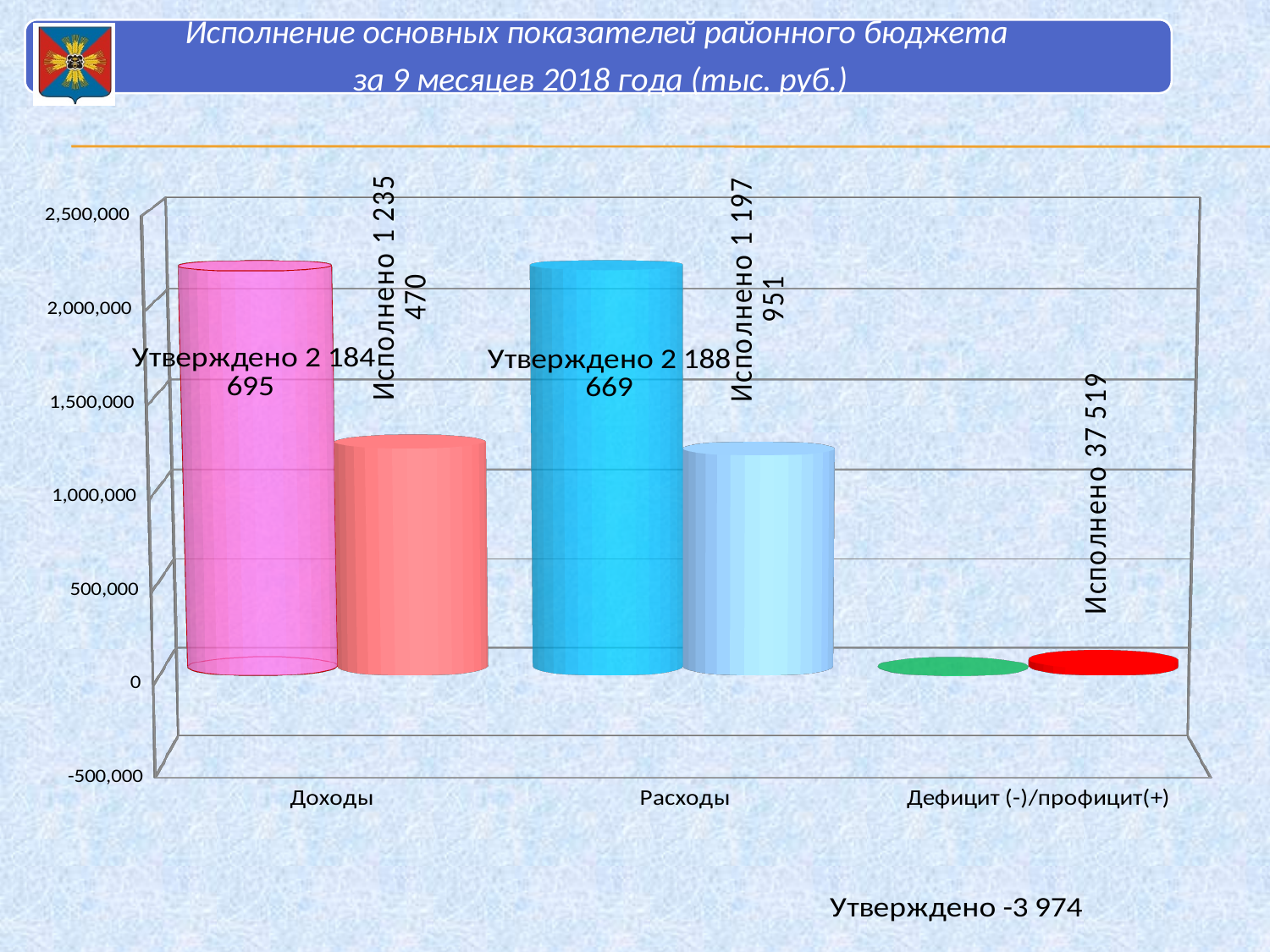
Is the executed value for Доходы greater or less than 1,000,000? greater Which is larger: the executed value for Доходы or the executed value for Расходы? Доходы What is the approved (Утверждено) value for Дефицит (-)/профицит(+)? -3 974 What is the executed (Исполнено) value for Дефицит (-)/профицит(+)? 37 519 What is the executed (Исполнено) value for Доходы? 1 235 470 What is the approved (Утверждено) value for Расходы? 2 188 669 What is the difference between the approved and executed values for Доходы? 949 225 What is the executed (Исполнено) value for Расходы? 1 197 951 How many categories are shown on the x axis of the chart? 3 What type of chart is shown on the slide? Bar chart What is the approved (Утверждено) value for Доходы? 2 184 695 What is the difference between the approved and executed values for Расходы? 990 718